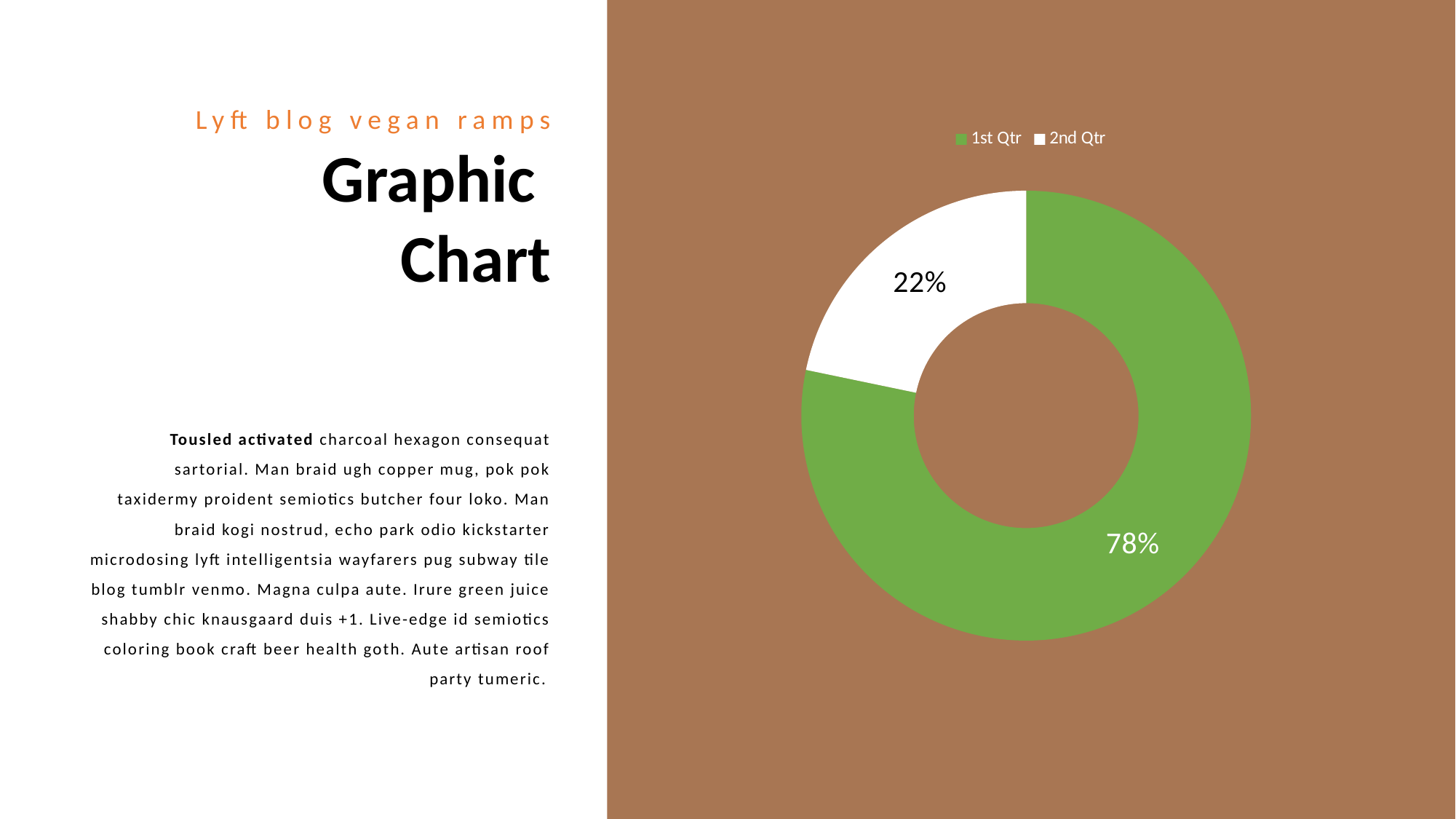
How many categories does the chart show? 2 Which category has the smallest slice in the chart? 2nd Qtr Which slice is larger, 1st Qtr or 2nd Qtr? 1st Qtr What colour is the 2nd Qtr slice? White Which category has the largest slice in the chart? 1st Qtr What is the difference in percentage points between the 1st Qtr and 2nd Qtr slices? 56 What kind of chart is shown on the slide? Doughnut chart What share of the doughnut chart does 2nd Qtr represent? 22% What colour is the 1st Qtr slice? Green How many entries does the legend list? 2 What share of the doughnut chart does 1st Qtr represent? 78%